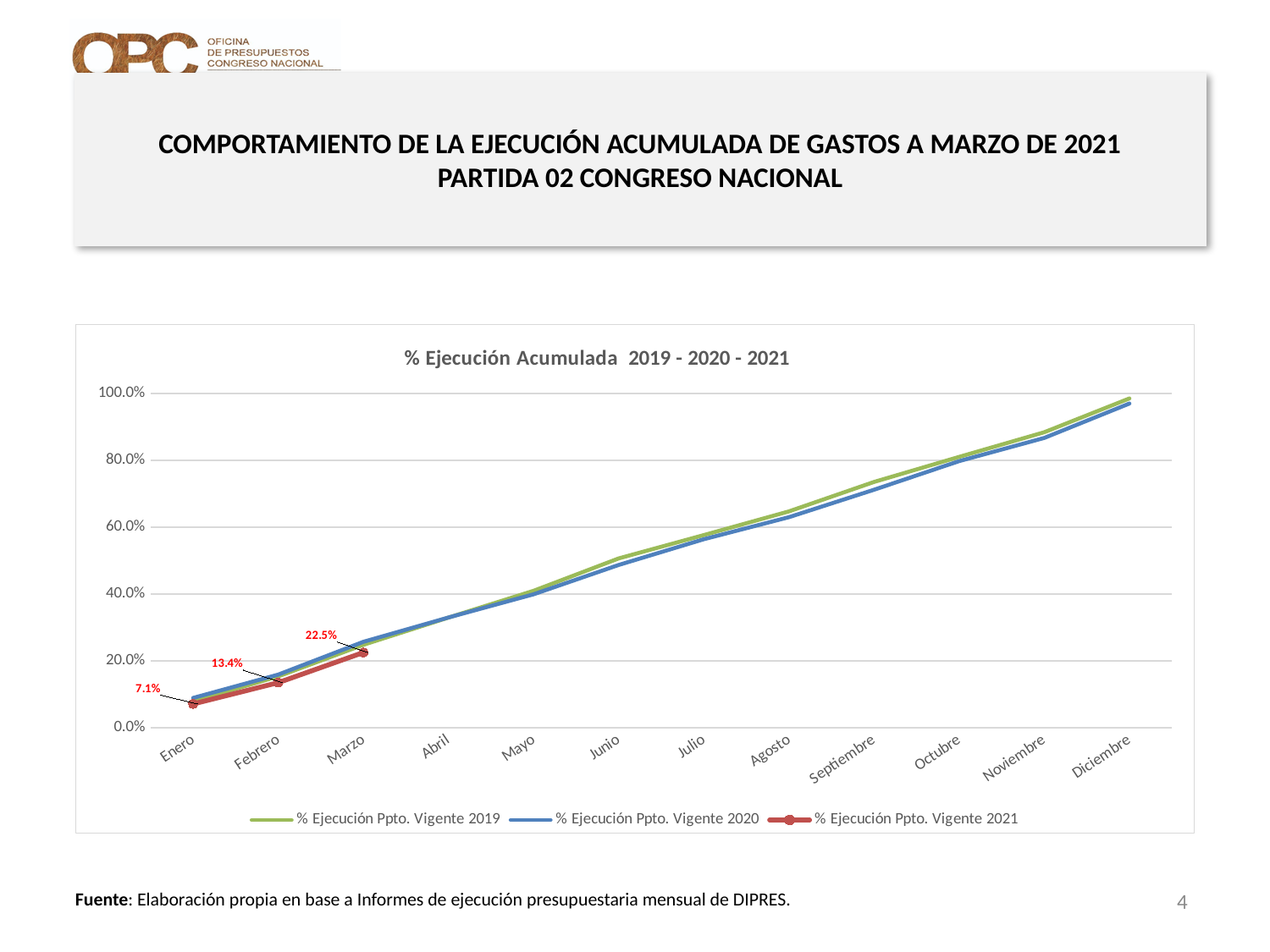
Which month has the highest value for the % Ejecución Ppto. Vigente 2021 series? Marzo What is the value of % Ejecución Ppto. Vigente 2021 for Marzo? 22.5% Is the value for % Ejecución Ppto. Vigente 2020 in Diciembre greater or less than 80.0%? greater How many series does the chart legend list? 3 What is the value of % Ejecución Ppto. Vigente 2021 for Febrero? 13.4% By how much does the 2021 series increase from Febrero to Marzo? 9.1% What kind of chart is shown on the slide? Line chart How many months are shown on the x axis of the chart? 12 What is the title of the chart? % Ejecución Acumulada 2019 - 2020 - 2021 What is the difference between the 2021 values for Enero and Marzo? 15.4% What is the value of % Ejecución Ppto. Vigente 2021 for Enero? 7.1% Do the values of the 2019 and 2020 series rise or fall from Enero to Diciembre? Rise